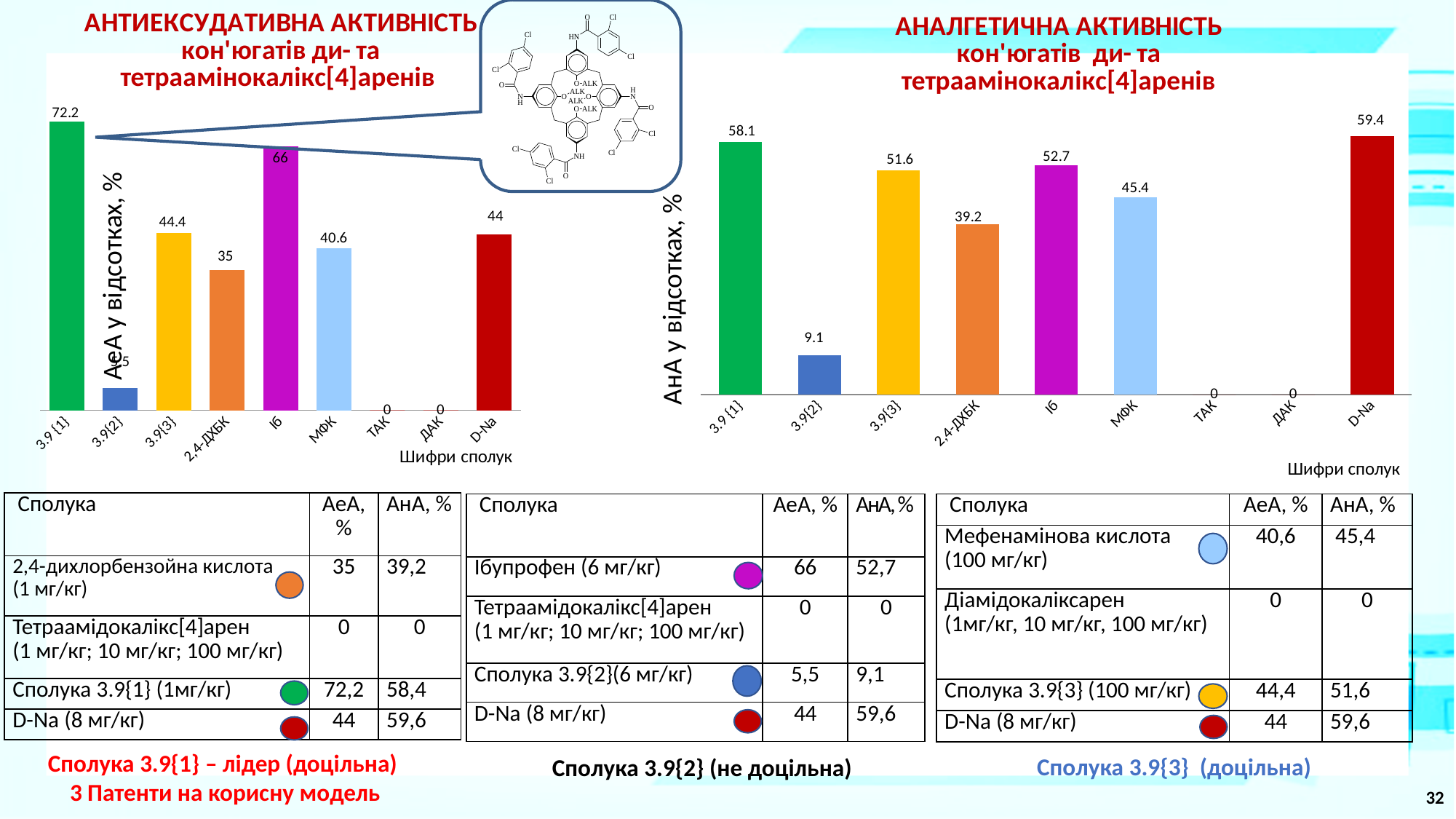
In the left chart (АНТИЕКСУДАТИВНА АКТИВНІСТЬ), which category has the highest value? 3.9 {1} In the right chart (АНАЛГЕТИЧНА АКТИВНІСТЬ), what is the value for МФК? 45.4 How many categories are shown on the x axis of the right chart (АНАЛГЕТИЧНА АКТИВНІСТЬ)? 9 In the left chart (АНТИЕКСУДАТИВНА АКТИВНІСТЬ), what is the value for 3.9 {1}? 72.2 In the right chart (АНАЛГЕТИЧНА АКТИВНІСТЬ), what is the difference between the values for 3.9 {1} and 2,4-ДХБК? 18.9 What kind of chart is the left chart (АНТИЕКСУДАТИВНА АКТИВНІСТЬ)? Bar chart In the left chart (АНТИЕКСУДАТИВНА АКТИВНІСТЬ), what is the value for Іб? 66 In the right chart (АНАЛГЕТИЧНА АКТИВНІСТЬ), which category has the highest value? D-Na In the left chart (АНТИЕКСУДАТИВНА АКТИВНІСТЬ), which is larger, the value for МФК or the value for D-Na? D-Na In the right chart (АНАЛГЕТИЧНА АКТИВНІСТЬ), which is larger, the value for 3.9{3} or the value for Іб? Іб In the right chart (АНАЛГЕТИЧНА АКТИВНІСТЬ), what is the value for 3.9{2}? 9.1 In the left chart (АНТИЕКСУДАТИВНА АКТИВНІСТЬ), what is the difference between the values for 3.9{3} and 2,4-ДХБК? 9.4